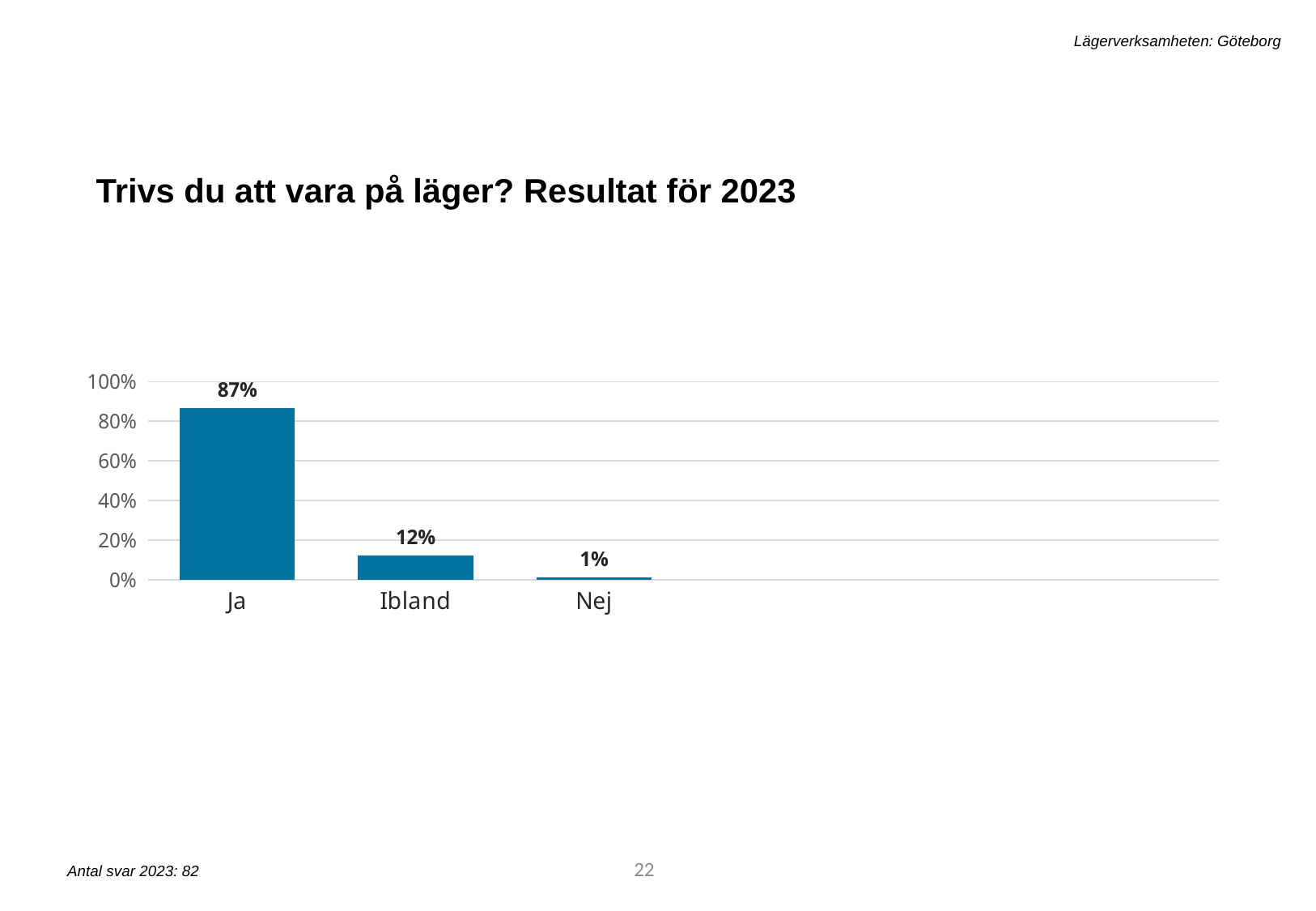
What is the title of the slide containing the chart? Trivs du att vara på läger? Resultat för 2023 What is the value for Ja? 87% Which category has the lowest value? Nej What is the difference between the values for Ja and Ibland? 75% What is the difference between the values for Ibland and Nej? 11% How many categories are shown on the x axis? 3 Is the value for Ja greater or less than 80%? greater Which category has the highest value? Ja What is the value for Ibland? 12% What kind of chart is shown on the slide? bar chart Which is larger, the value for Ibland or the value for Nej? Ibland What is the value for Nej? 1%